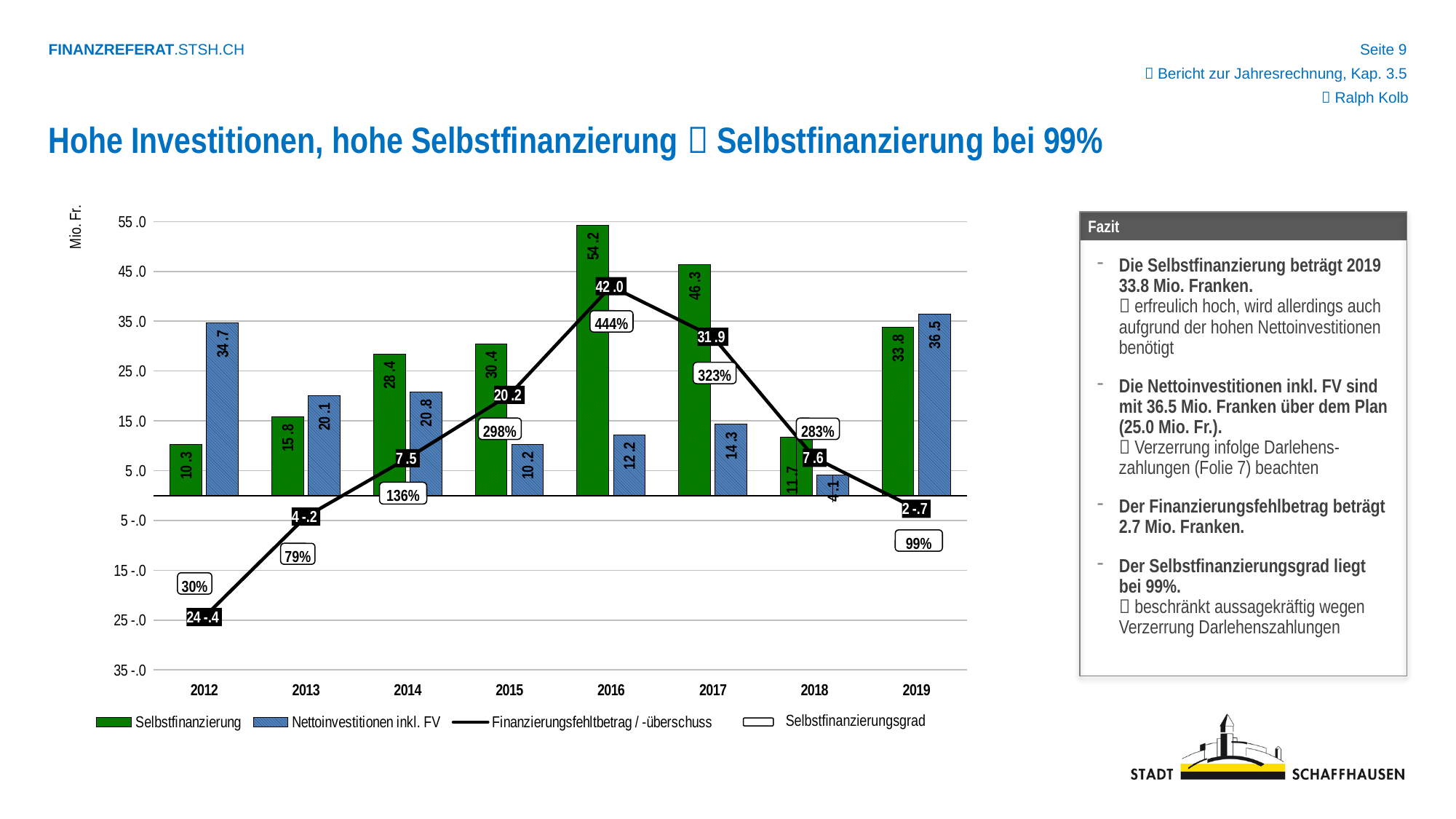
What is the Nettoinvestitionen inkl. FV value for 2019? 36.5 Which is larger in 2012, Selbstfinanzierung or Nettoinvestitionen inkl. FV? Nettoinvestitionen inkl. FV How many years are shown on the x axis of the chart? 8 In which year is the Selbstfinanzierung highest? 2016 What is the Selbstfinanzierungsgrad for 2016? 444% What is the difference between Nettoinvestitionen inkl. FV and Selbstfinanzierung in 2019? 2.7 What is the Finanzierungsfehlbetrag / -überschuss value for 2017? 31.9 What unit is shown on the y axis of the chart? Mio. Fr. In which year is the Nettoinvestitionen inkl. FV lowest? 2018 What kind of chart is shown on the slide? Combined bar and line chart What is the Selbstfinanzierung value for 2016? 54.2 How many series does the chart legend list? 4